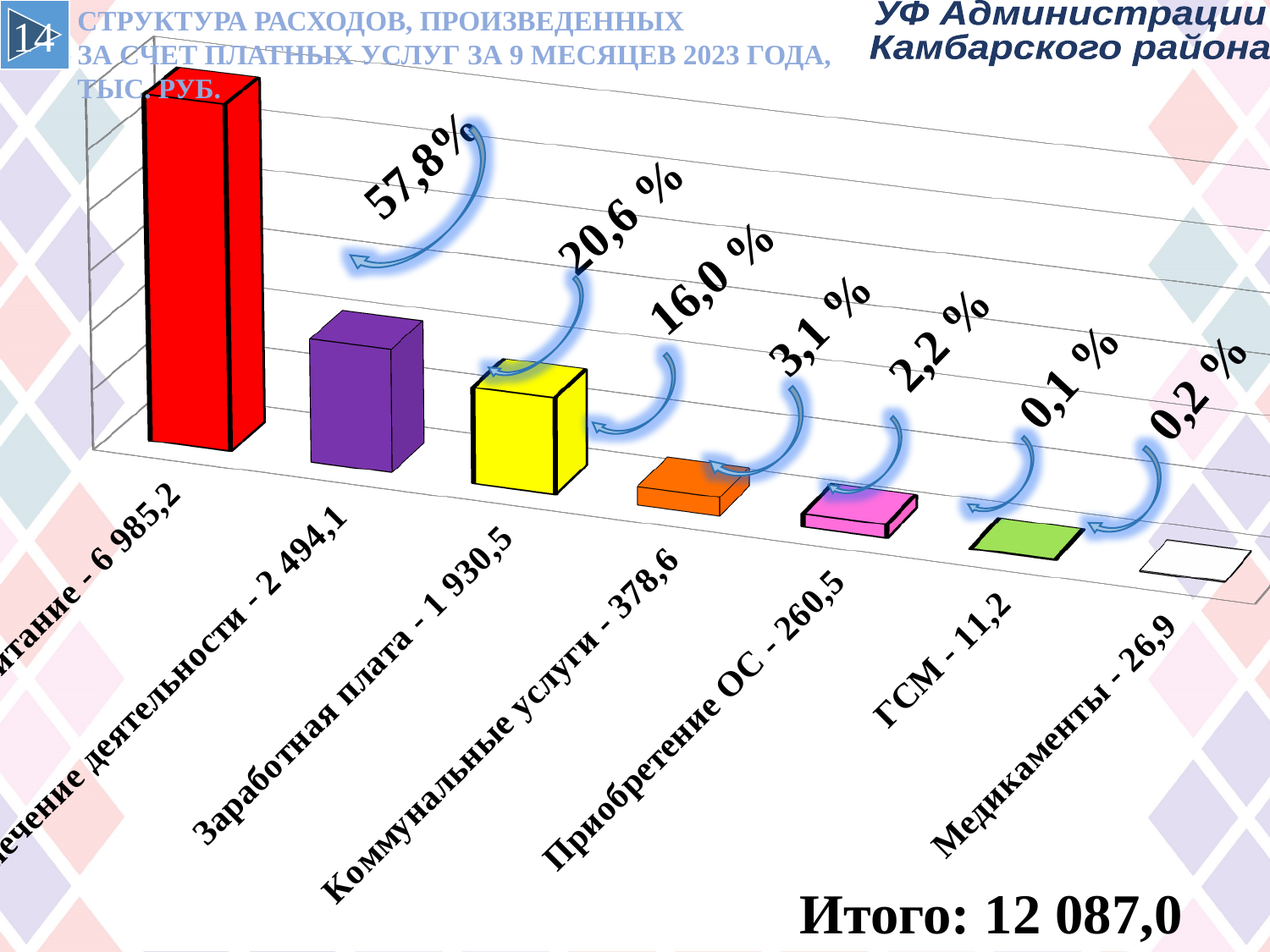
Which category has the lowest value? ГСМ What is the value for Приобретение ОС? 260,5 What total (Итого) is printed on the slide? 12 087,0 What is the difference between Коммунальные услуги and Приобретение ОС? 118,1 What is the value for Заработная плата? 1 930,5 What percentage share is shown for Заработная плата? 16,0 % What kind of chart is shown on the slide? bar chart Which is larger, Медикаменты or ГСМ? Медикаменты How many categories are shown in the chart? 7 What is the value for Медикаменты? 26,9 What is the value for ГСМ? 11,2 What is the value for Коммунальные услуги? 378,6